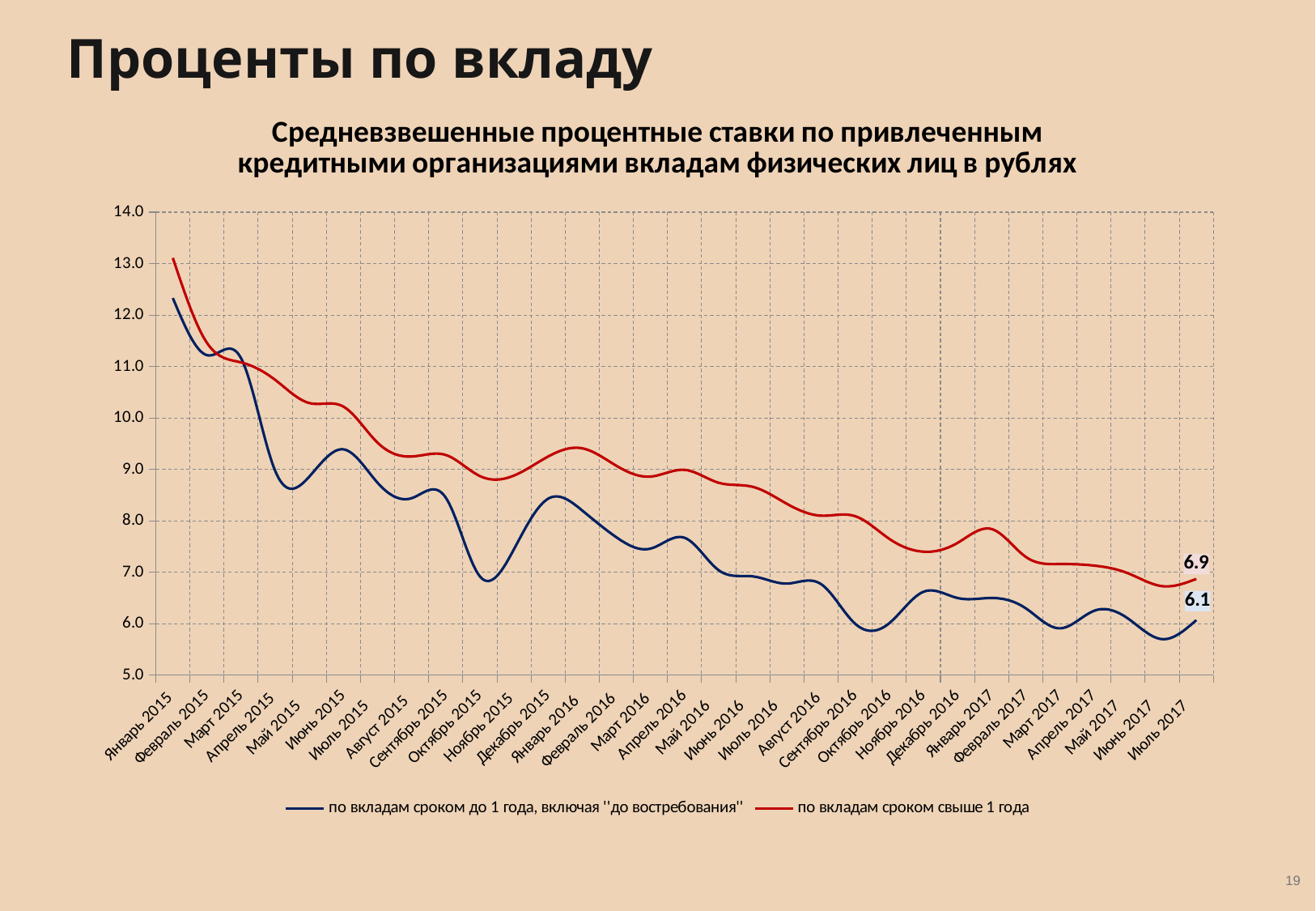
Is the value for "по вкладам сроком свыше 1 года" in Июнь 2015 greater or less than 10.0? greater How many months are plotted along the x axis? 31 Is the value for "по вкладам сроком до 1 года, включая ''до востребования''" in Январь 2015 greater or less than 12.0? greater What is the value for "по вкладам сроком до 1 года, включая ''до востребования''" in Июль 2017? 6.1 Which series has the larger value in Июль 2017? по вкладам сроком свыше 1 года What is the value for "по вкладам сроком свыше 1 года" in Июль 2017? 6.9 Do the values of "по вкладам сроком свыше 1 года" generally rise or fall from Январь 2015 to Июль 2017? fall What kind of chart is shown on the slide? line chart What is the difference between the two series' values in Июль 2017? 0.8 How many series does the legend list? 2 What colour is the line for "по вкладам сроком свыше 1 года"? red Is the value for "по вкладам сроком до 1 года, включая ''до востребования''" in Июнь 2017 greater or less than 6.0? less